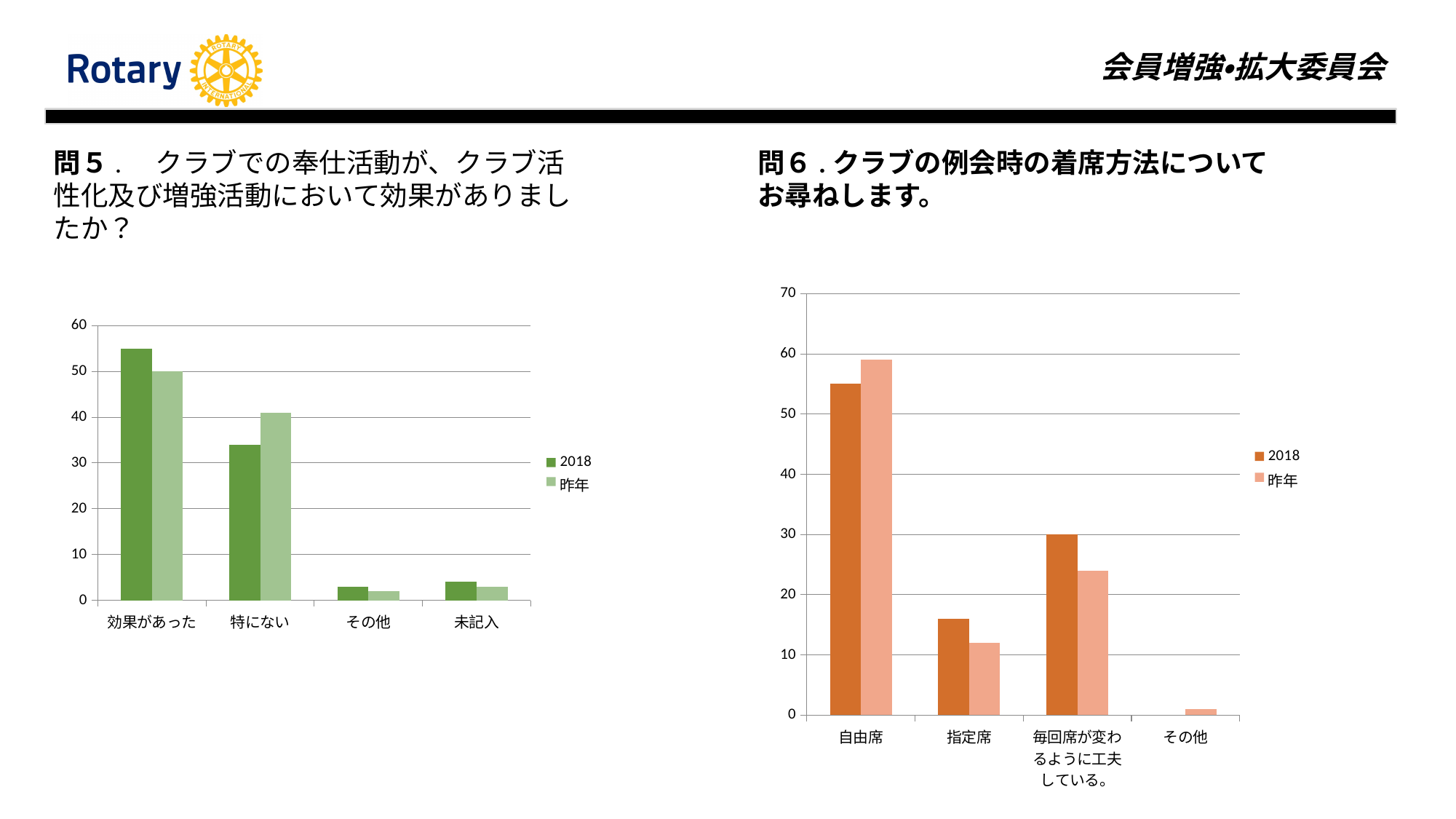
In the left chart (問5), which category has the highest value for the 2018 series? 効果があった In the left chart (問5), is the 2018 value for 効果があった greater or less than 50? greater How many categories are shown on the x axis of the left chart (問5)? 4 In the left chart (問5), for 特にない, which series has the larger value, 2018 or 昨年? 昨年 In the right chart (問6), for 自由席, which series has the larger value, 2018 or 昨年? 昨年 How many series does the legend of the right chart (問6) list? 2 In the right chart (問6), is the 2018 value for 指定席 greater or less than 20? less What kind of chart is the left chart (問5)? bar chart In the right chart (問6), which category has the highest value for the 昨年 series? 自由席 What are the two legend entries of the left chart (問5)? 2018 and 昨年